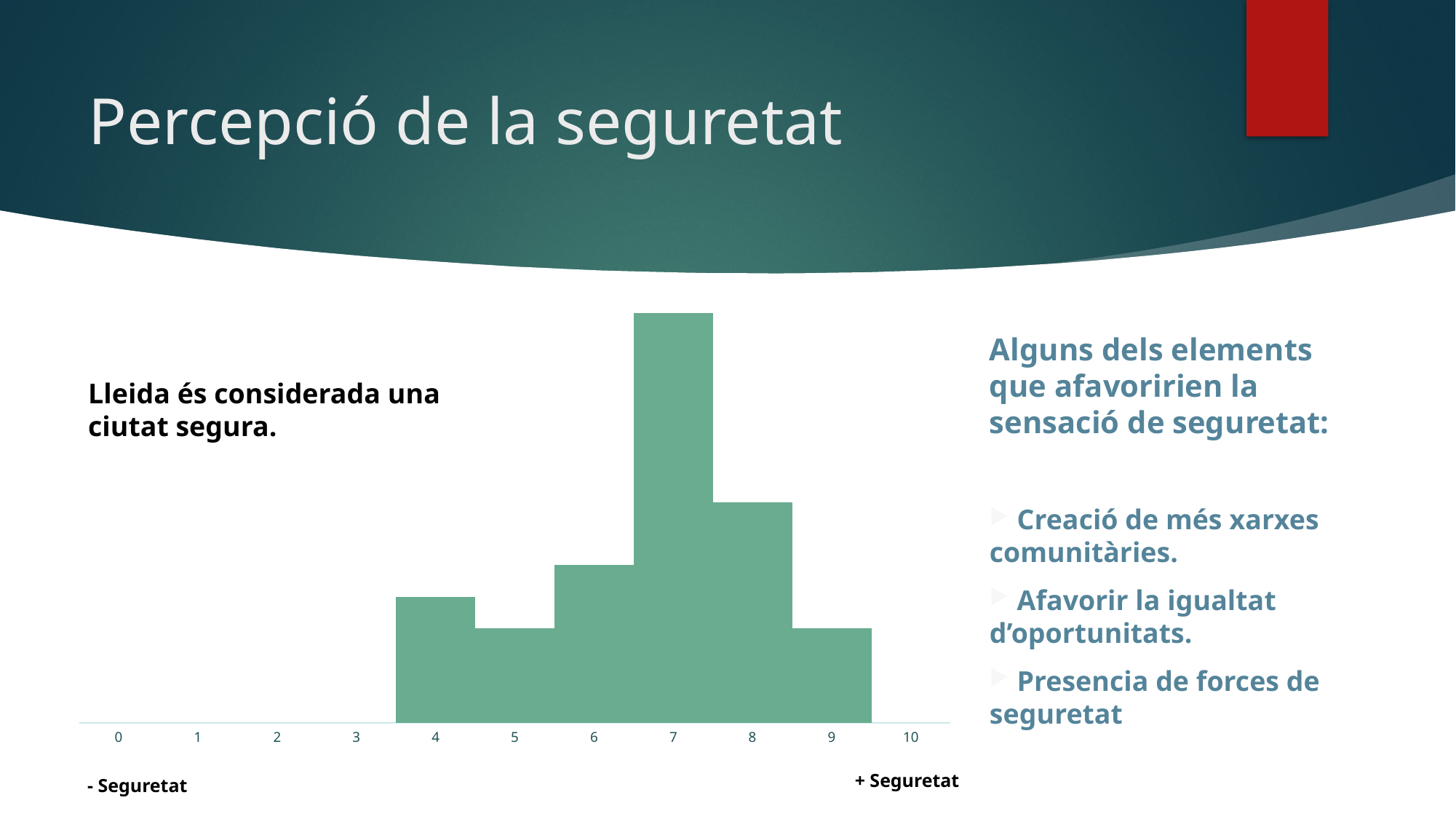
Is the bar at 6 taller or shorter than the bar at 9? taller Is the bar at 7 taller or shorter than the bar at 8? taller Is the bar at 8 taller or shorter than the bar at 6? taller Which x-axis value has the tallest bar? 7 Do the bars rise or fall from x = 5 to x = 7? rise What kind of chart is shown on the slide? bar chart Which x-axis value has the second tallest bar? 8 What label appears at the right end of the x axis, below the chart? + Seguretat How many tick labels are shown on the x axis? 11 Do the bars rise or fall from x = 7 to x = 9? fall How many visible bars does the chart have? 6